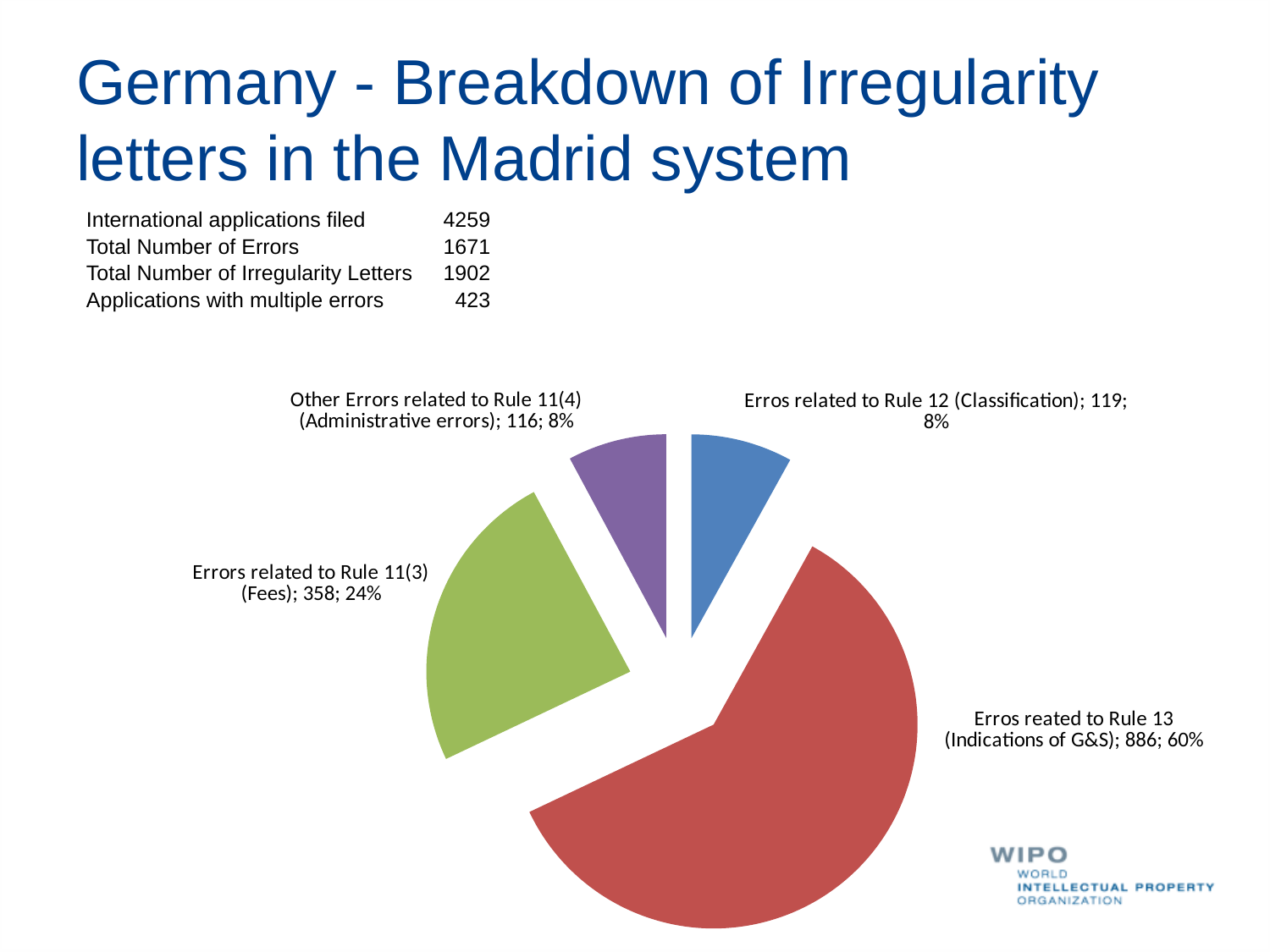
What share of the pie does Errors related to Rule 11(3) (Fees) represent? 24% Which category has the largest slice of the pie? Errors related to Rule 13 (Indications of G&S) Which is larger, the value for Errors related to Rule 11(3) (Fees) or Errors related to Rule 12 (Classification)? Errors related to Rule 11(3) (Fees) What share of the pie does Errors related to Rule 13 (Indications of G&S) represent? 60% What colour is the slice for Errors related to Rule 11(3) (Fees)? Green What is the value for Errors related to Rule 12 (Classification)? 119 What is the value for Errors related to Rule 13 (Indications of G&S)? 886 What kind of chart is shown on the slide? Pie chart What is the difference between the values for Errors related to Rule 13 (Indications of G&S) and Errors related to Rule 11(3) (Fees)? 528 What is the value for Errors related to Rule 11(3) (Fees)? 358 How many slices does the pie chart have? 4 What is the value for Other Errors related to Rule 11(4) (Administrative errors)? 116